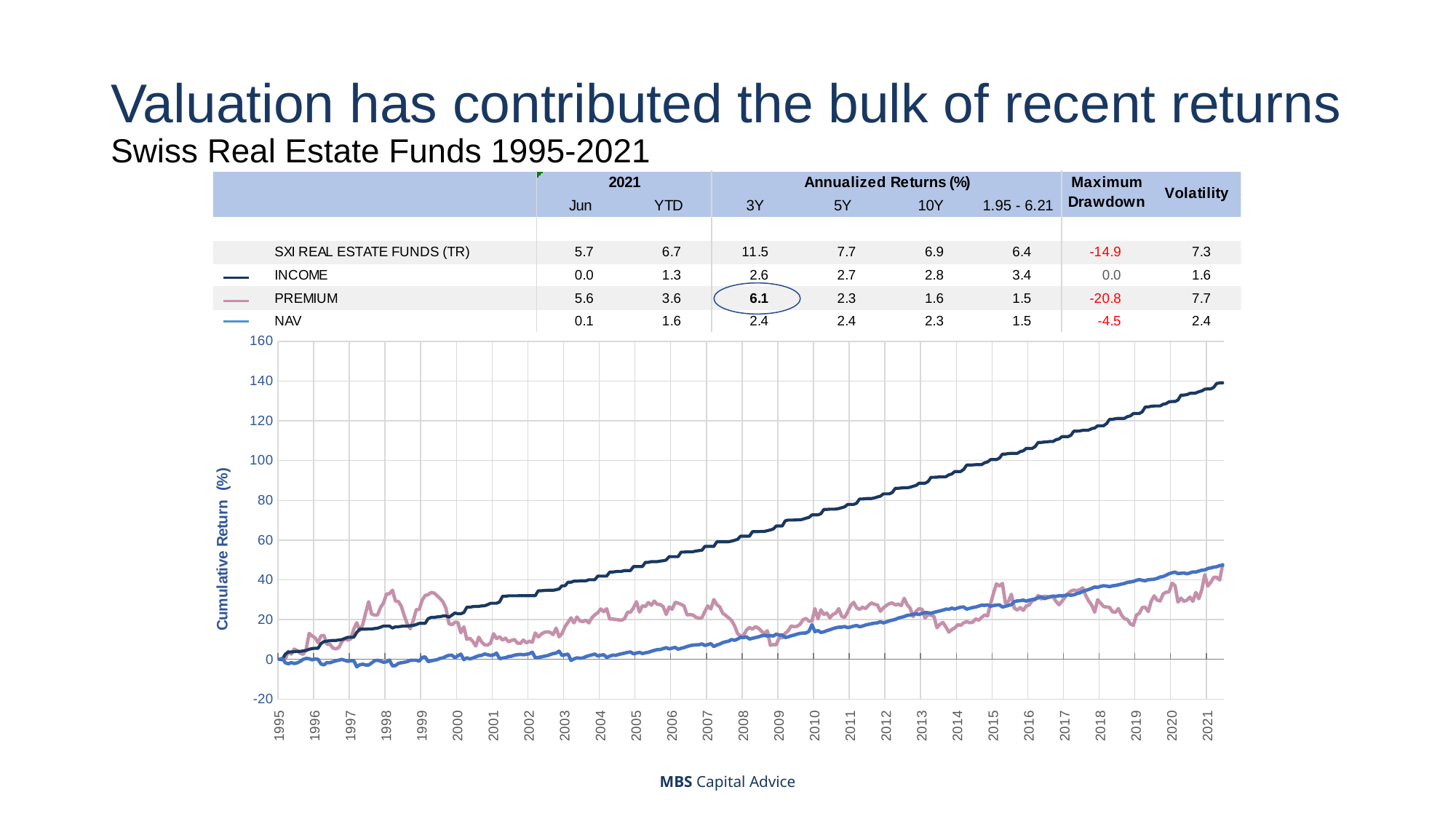
Which series has the highest cumulative return at the end of the chart in 2021? INCOME Is the cumulative return for PREMIUM in 2010 greater or less than 40? less How many series are plotted in the chart? 3 What is the label of the y axis of the chart? Cumulative Return (%) Is the cumulative return for NAV in 2021 greater or less than 60? less Is the cumulative return for INCOME in 2021 greater or less than 120? greater In the table above the chart, what is the 3Y annualized return for PREMIUM? 6.1 Does the INCOME line rise or fall from 1995 to 2021? rises What kind of chart is shown on the slide? line chart Which series has the lowest cumulative return around 2003? NAV How many year labels are shown on the x axis of the chart? 27 At the end of 2021, which is larger: the cumulative return for INCOME or for NAV? INCOME